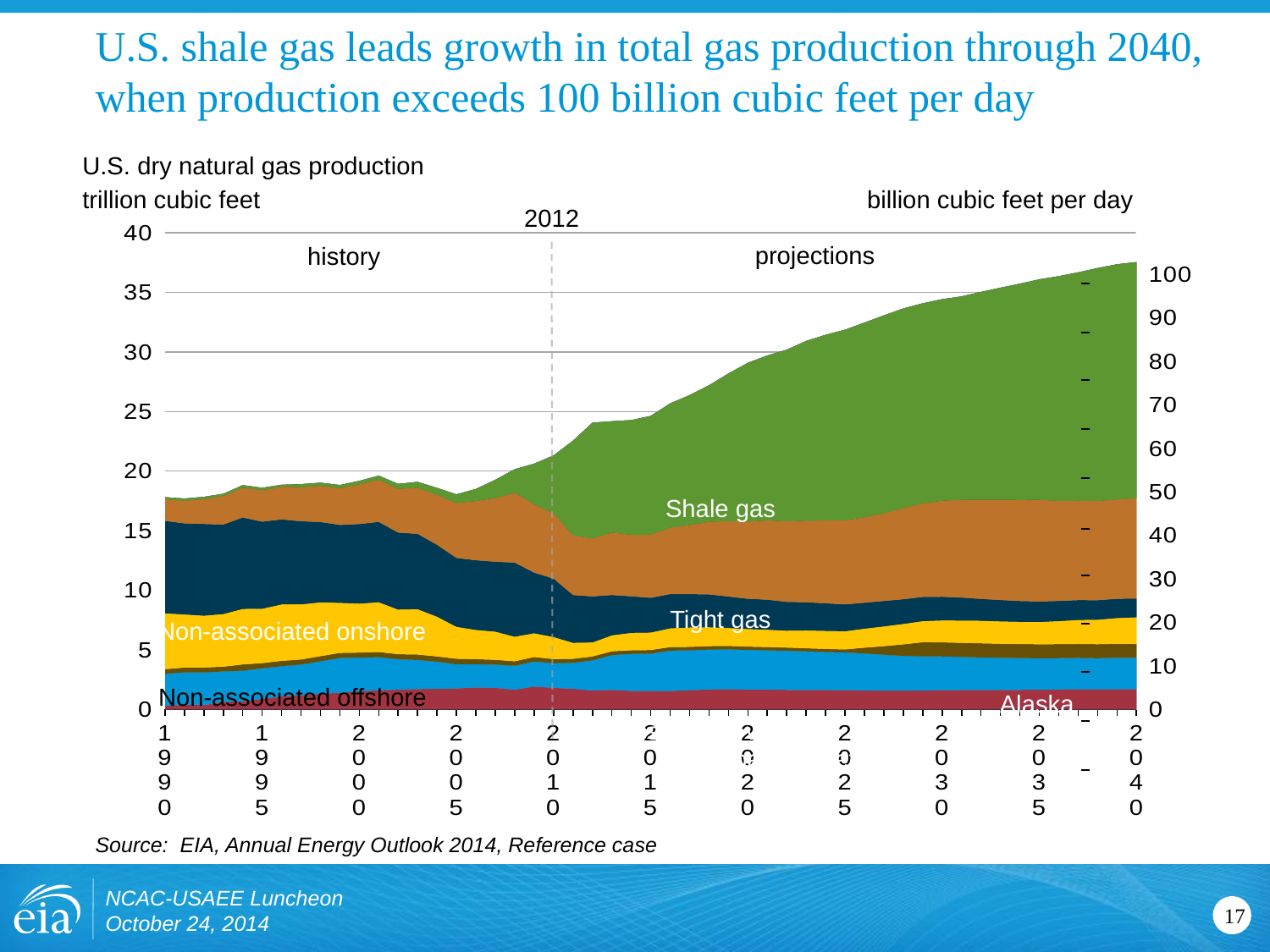
Does total U.S. dry natural gas production rise or fall between 2012 and 2040? Rise How many production categories are labeled directly on the chart? 5 What year does the dashed vertical line separating history from projections mark? 2012 Does the Shale gas area grow or shrink between 2010 and 2040? Grow Does the Non-associated onshore area grow or shrink between 1990 and 2040? Shrink Is total production in 2040 greater or less than 100 billion cubic feet per day? greater Which category is the largest contributor to total production in 2040? Shale gas Is total production in 2012 greater or less than 20 trillion cubic feet? greater What unit is shown on the left vertical axis of the chart? trillion cubic feet What kind of chart is shown on the slide? Stacked area chart Is total production in 1990 greater or less than 20 trillion cubic feet? less